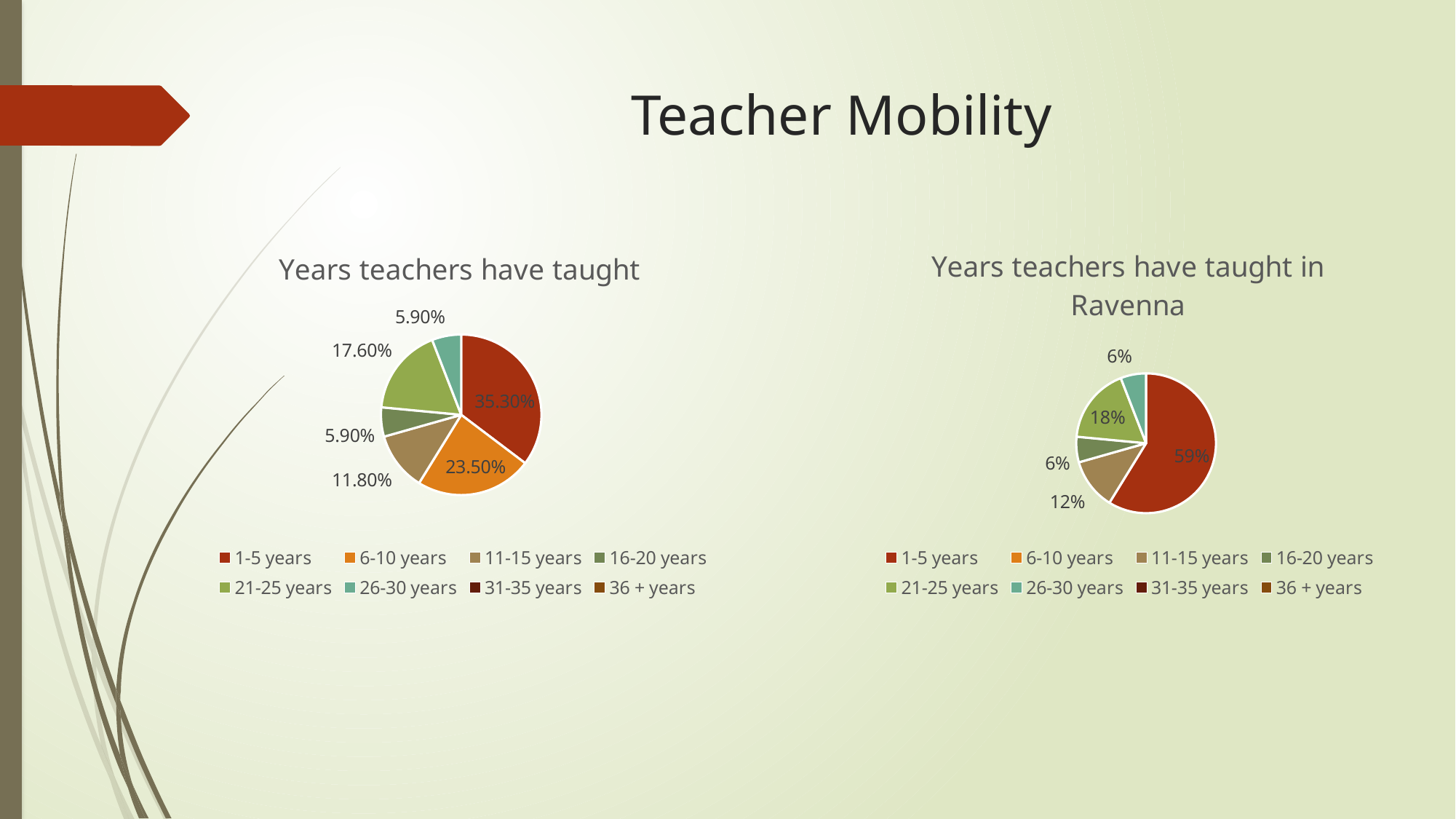
In the 'Years teachers have taught' chart, what is the difference between the 1-5 years slice and the 6-10 years slice? 11.80% What kind of chart is the 'Years teachers have taught' chart? Pie chart In the 'Years teachers have taught in Ravenna' chart, which category has the largest slice? 1-5 years In the 'Years teachers have taught in Ravenna' chart, what share of teachers have taught 1-5 years in Ravenna? 59% How many entries does the legend of the 'Years teachers have taught in Ravenna' chart list? 8 In the 'Years teachers have taught' chart, what share of teachers have taught 1-5 years? 35.30% In the 'Years teachers have taught in Ravenna' chart, what share of teachers have taught 11-15 years in Ravenna? 12% In the 'Years teachers have taught in Ravenna' chart, what share of teachers have taught 21-25 years in Ravenna? 18% In the 'Years teachers have taught' chart, what share of teachers have taught 6-10 years? 23.50% In the 'Years teachers have taught' chart, which category has the largest slice? 1-5 years In the 'Years teachers have taught' chart, what share of teachers have taught 21-25 years? 17.60% In the 'Years teachers have taught in Ravenna' chart, which is larger: the 21-25 years slice or the 11-15 years slice? 21-25 years